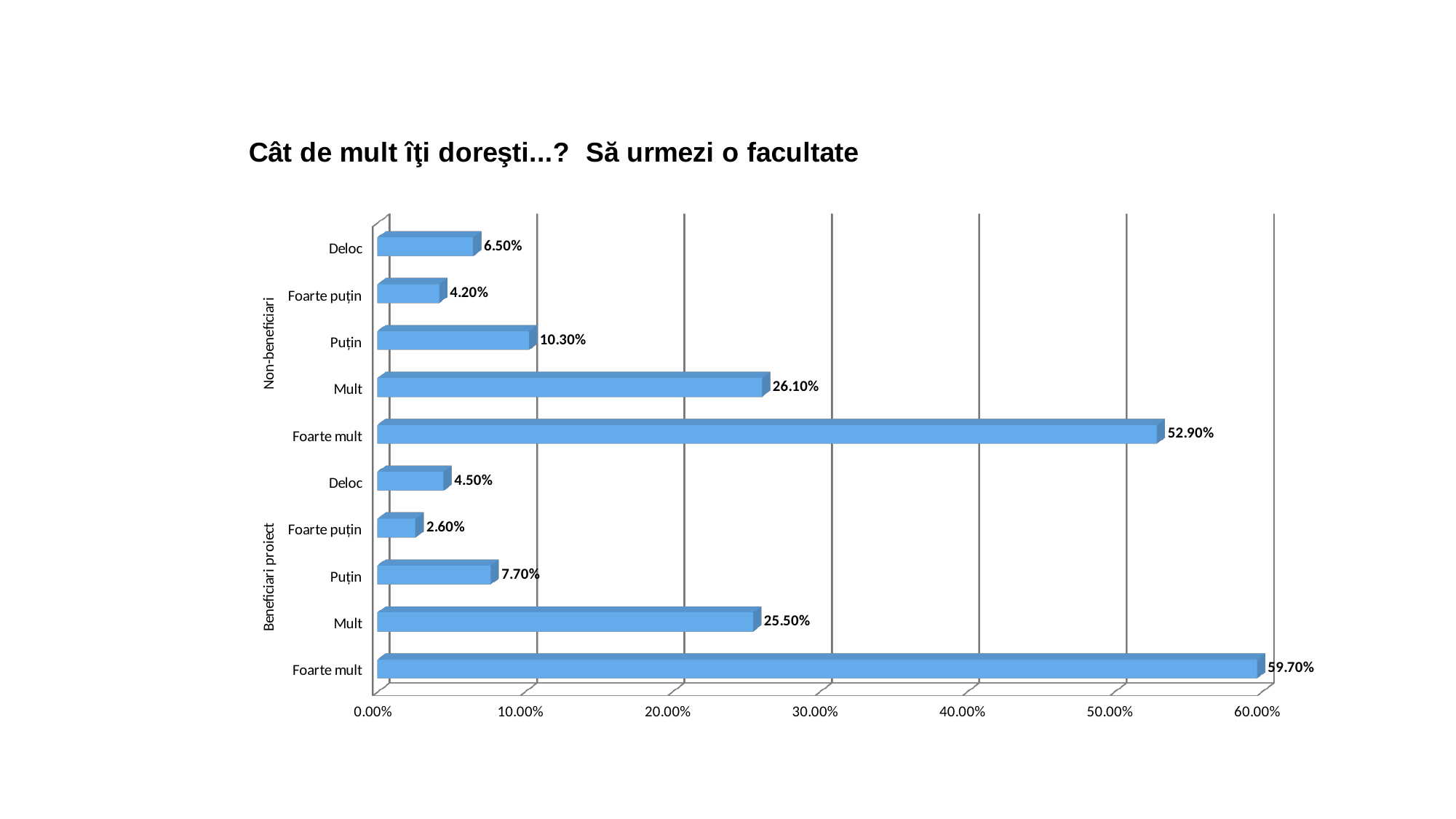
What is the difference between "Foarte mult" for Beneficiari proiect and "Foarte mult" for Non-beneficiari? 6.80% Which bar has the lowest value on the chart? Foarte puțin (Beneficiari proiect) How many bars are plotted on the chart? 10 Is the value for "Mult" in the Beneficiari proiect group greater or less than 30.00%? less What is the value for "Foarte puțin" in the Beneficiari proiect group? 2.60% Which is larger: "Puțin" for Non-beneficiari or "Puțin" for Beneficiari proiect? Puțin for Non-beneficiari What is the value for "Mult" in the Non-beneficiari group? 26.10% What is the value for "Foarte mult" in the Beneficiari proiect group? 59.70% What is the difference between "Deloc" for Non-beneficiari and "Deloc" for Beneficiari proiect? 2.00% Which bar has the highest value on the chart? Foarte mult (Beneficiari proiect) What kind of chart is shown on the slide? bar chart What is the title of the chart? Cât de mult îţi doreşti...? Să urmezi o facultate